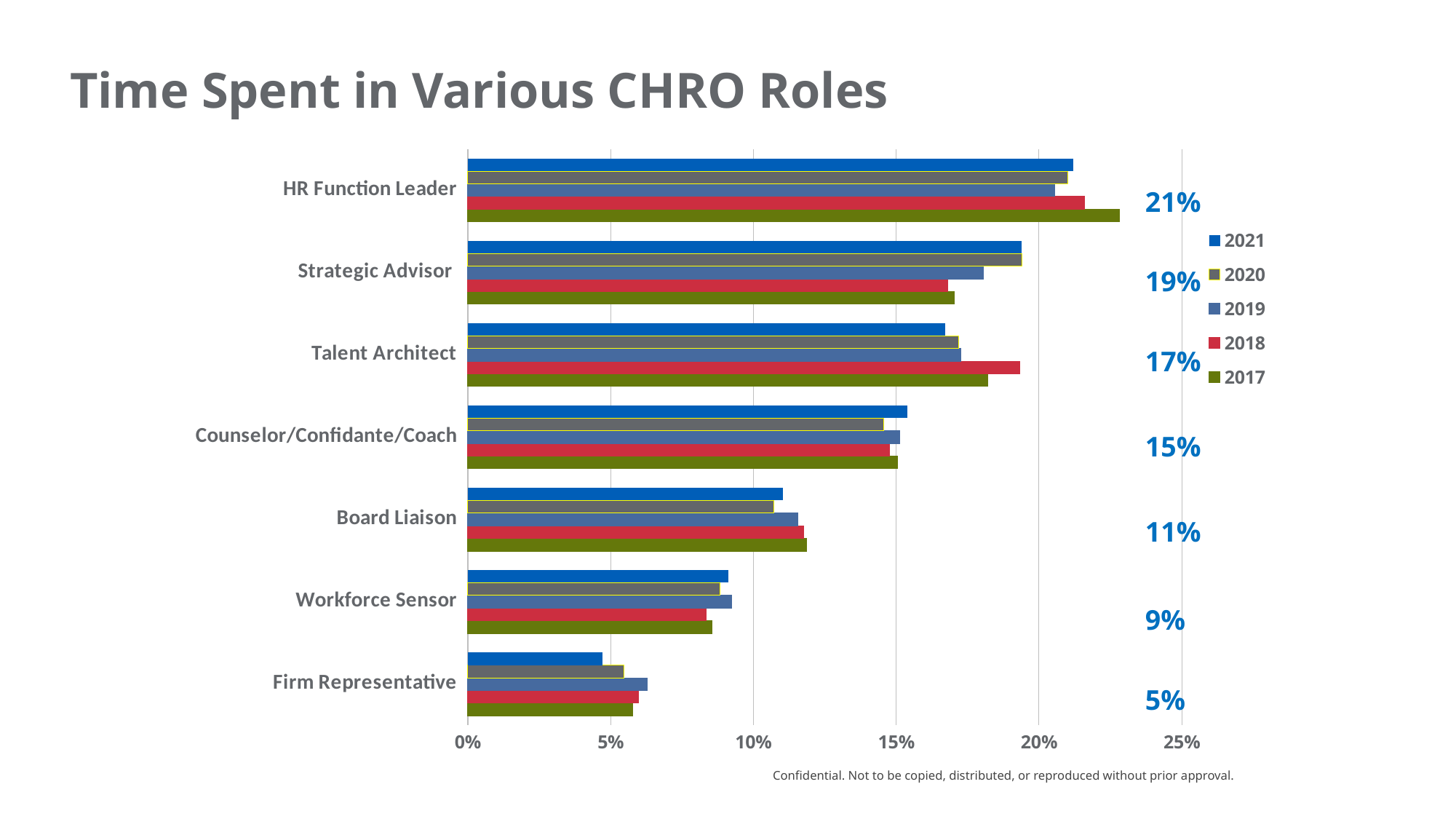
What kind of chart is shown on the slide? bar chart What percentage is shown next to Board Liaison? 11% How many series does the legend list? 5 How many CHRO roles are listed on the chart? 7 Which role has the highest share of time spent? HR Function Leader What percentage is shown next to Firm Representative? 5% What is the difference between the percentages shown for HR Function Leader and Firm Representative? 16% Is the 2017 value for HR Function Leader greater or less than 20%? greater For Talent Architect, which is larger: the 2018 bar or the 2021 bar? 2018 What is the title of the chart? Time Spent in Various CHRO Roles What percentage is shown next to HR Function Leader? 21% Which role has the lowest share of time spent? Firm Representative